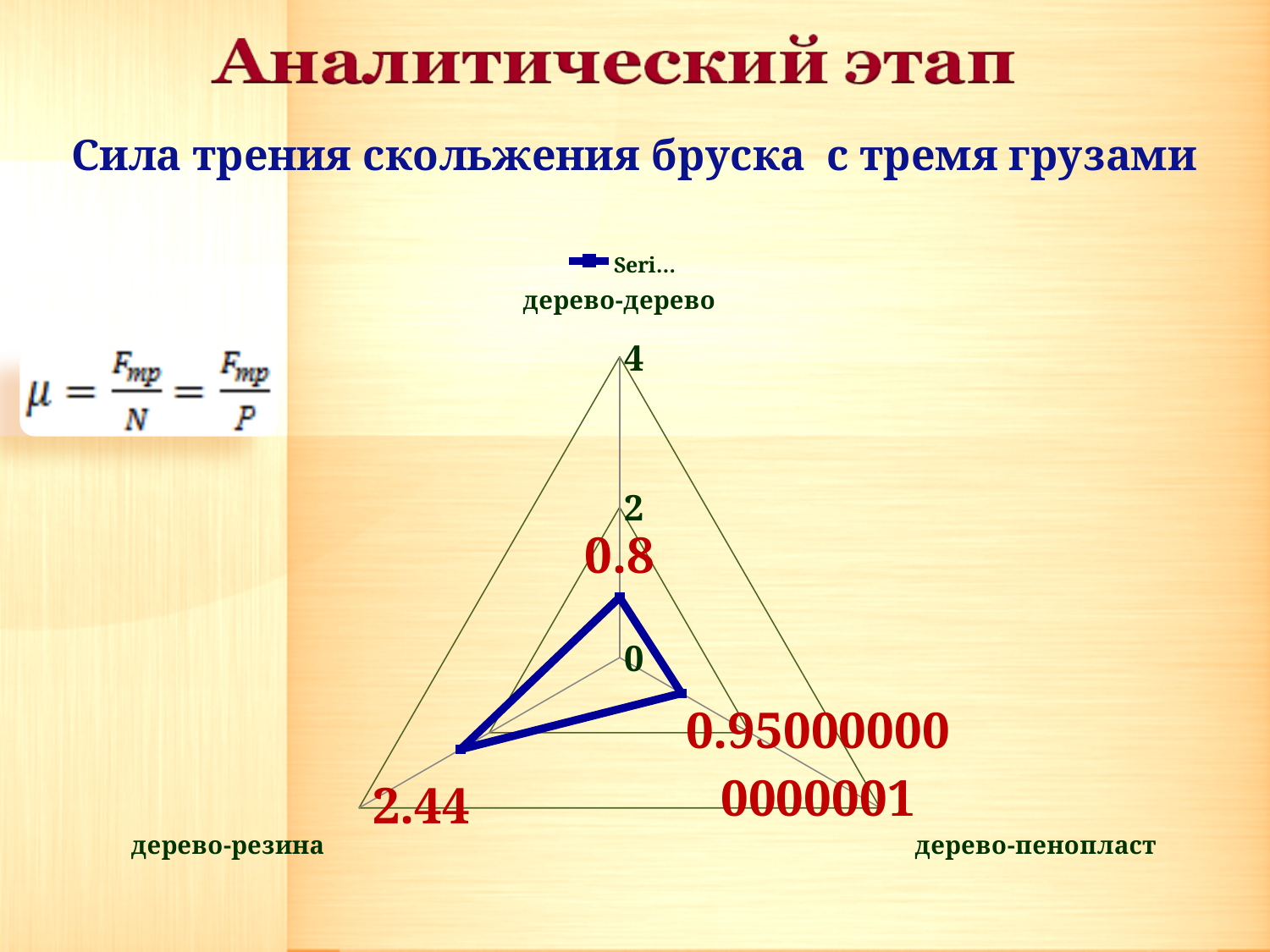
What is the difference between the values for дерево-резина and дерево-дерево? 1.64 How many categories are plotted on the chart? 3 What is the value for дерево-резина? 2.44 Is the value for дерево-дерево greater or less than 2? less What is the maximum value shown on the chart's axis? 4 What kind of chart is shown on the slide? radar chart Is the value for дерево-резина greater or less than 2? greater Which category has the highest value? дерево-резина Which category has the lowest value? дерево-дерево What is the value for дерево-дерево? 0.8 Which is larger, the value for дерево-дерево or for дерево-пенопласт? дерево-пенопласт What is the value for дерево-пенопласт? 0.950000000000001